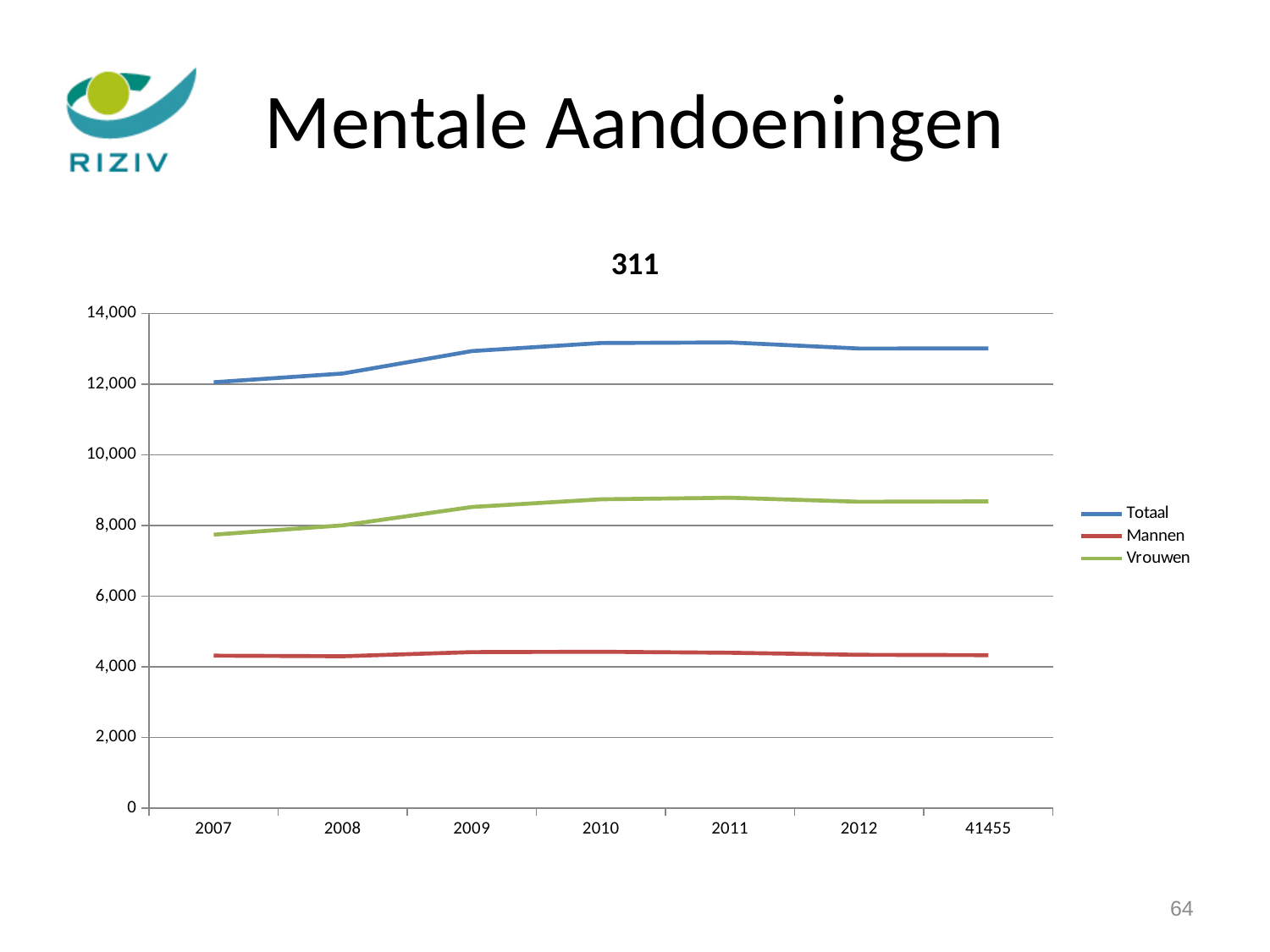
Is the value for Mannen in 2009 greater or less than 4,000? greater How many points are plotted along the x axis for each series? 7 What kind of chart is shown on the slide? line chart How many series does the legend list? 3 Is the value for Vrouwen in 2012 greater or less than 8,000? greater Is the value for Vrouwen in 2007 greater or less than 8,000? less What is the title of the chart? 311 In 2011, which is larger: Vrouwen or Mannen? Vrouwen Which series has the lowest values across all years? Mannen Does the Totaal line rise or fall from 2007 to 2009? rise